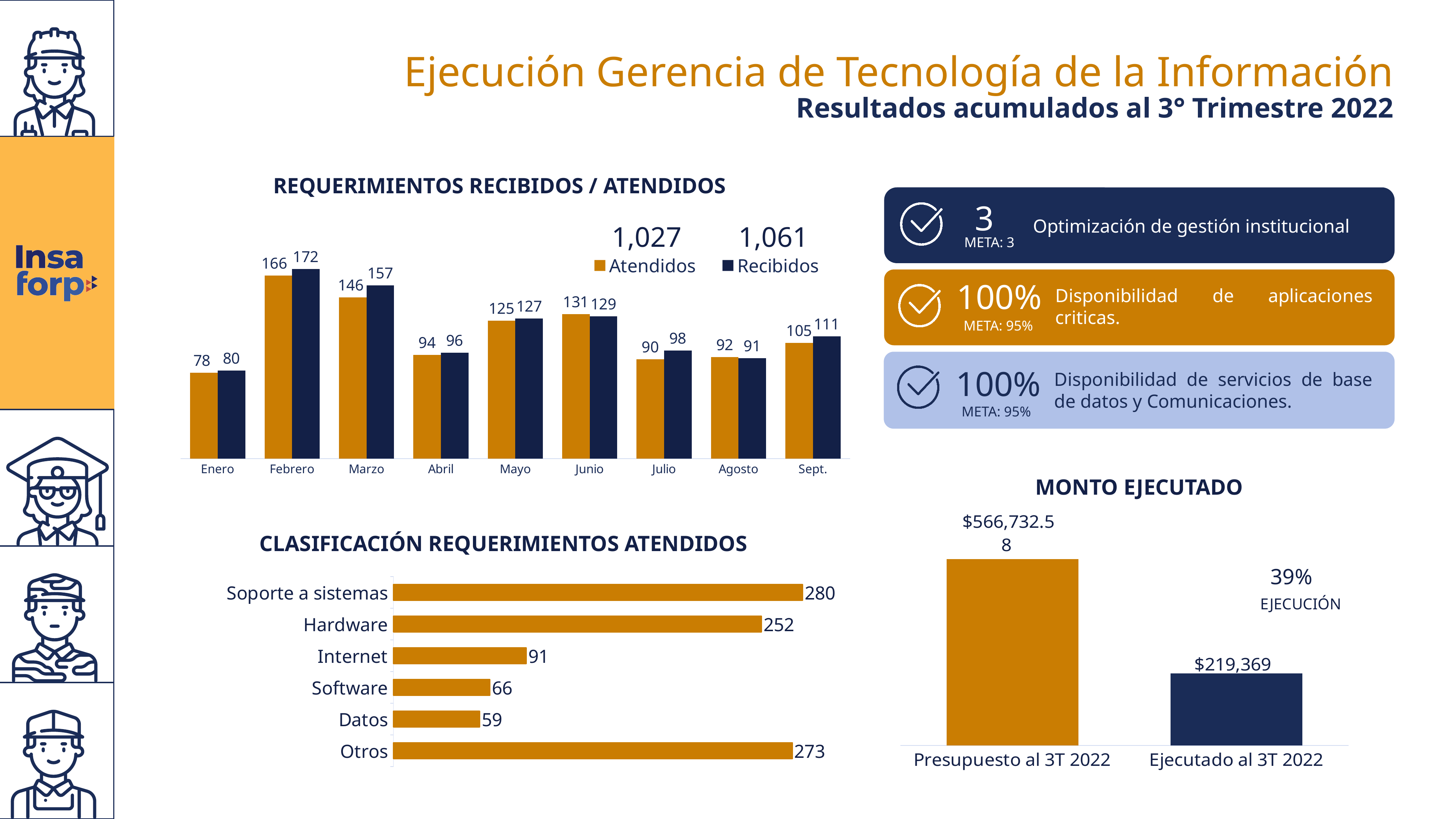
In the 'CLASIFICACIÓN REQUERIMIENTOS ATENDIDOS' chart, what is the value for Hardware? 252 In the 'REQUERIMIENTOS RECIBIDOS / ATENDIDOS' chart, how many months are shown on the x axis? 9 In the 'REQUERIMIENTOS RECIBIDOS / ATENDIDOS' chart, how many series does the legend list? 2 In the 'CLASIFICACIÓN REQUERIMIENTOS ATENDIDOS' chart, which category has the lowest value? Datos What kind of chart is the 'CLASIFICACIÓN REQUERIMIENTOS ATENDIDOS' chart? Bar chart In the 'REQUERIMIENTOS RECIBIDOS / ATENDIDOS' chart, which month has the lowest Atendidos value? Enero In the 'REQUERIMIENTOS RECIBIDOS / ATENDIDOS' chart, which month has the highest Recibidos value? Febrero In the 'CLASIFICACIÓN REQUERIMIENTOS ATENDIDOS' chart, which is larger, Internet or Software? Internet In the 'MONTO EJECUTADO' chart, what is the value for Ejecutado al 3T 2022? $219,369 In the 'REQUERIMIENTOS RECIBIDOS / ATENDIDOS' chart, what is the difference between Recibidos and Atendidos in Marzo? 11 In the 'REQUERIMIENTOS RECIBIDOS / ATENDIDOS' chart, what is the Recibidos value for Marzo? 157 In the 'REQUERIMIENTOS RECIBIDOS / ATENDIDOS' chart, what is the Atendidos value for Febrero? 166